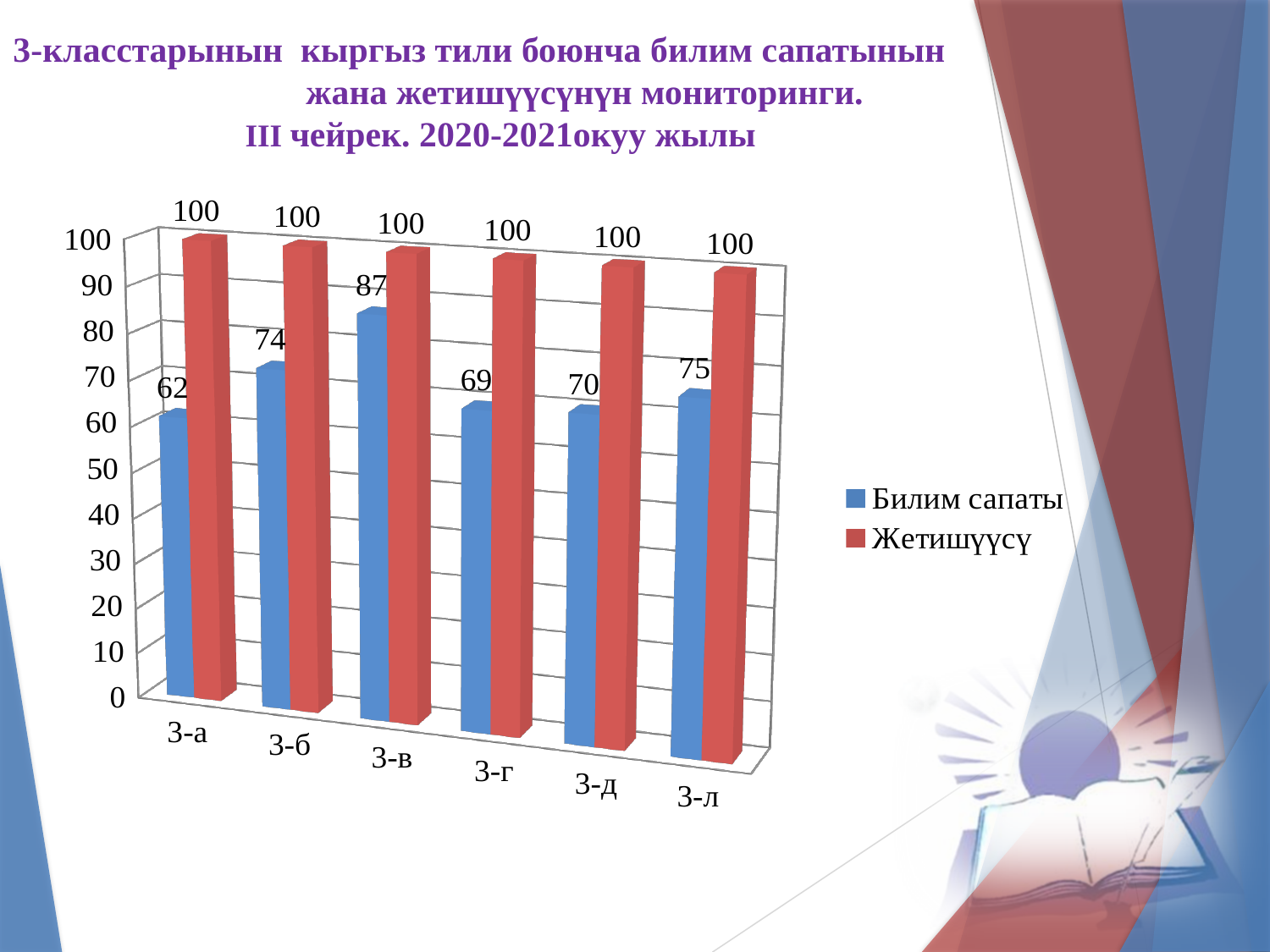
How many series does the legend list? 2 Is the Билим сапаты value for 3-д greater or less than 80? less How many classes are shown on the x axis? 6 What is the difference between the Билим сапаты values for 3-в and 3-а? 25 Which class has the highest Билим сапаты value? 3-в What is the value of Билим сапаты for 3-а? 62 What kind of chart is shown on the slide? bar chart What is the value of Жетишүүсү for 3-г? 100 Which colour represents Жетишүүсү in the chart? red Which class has the lowest Билим сапаты value? 3-а What is the value of Билим сапаты for 3-в? 87 Which is larger, the Билим сапаты value for 3-б or for 3-л? 3-л